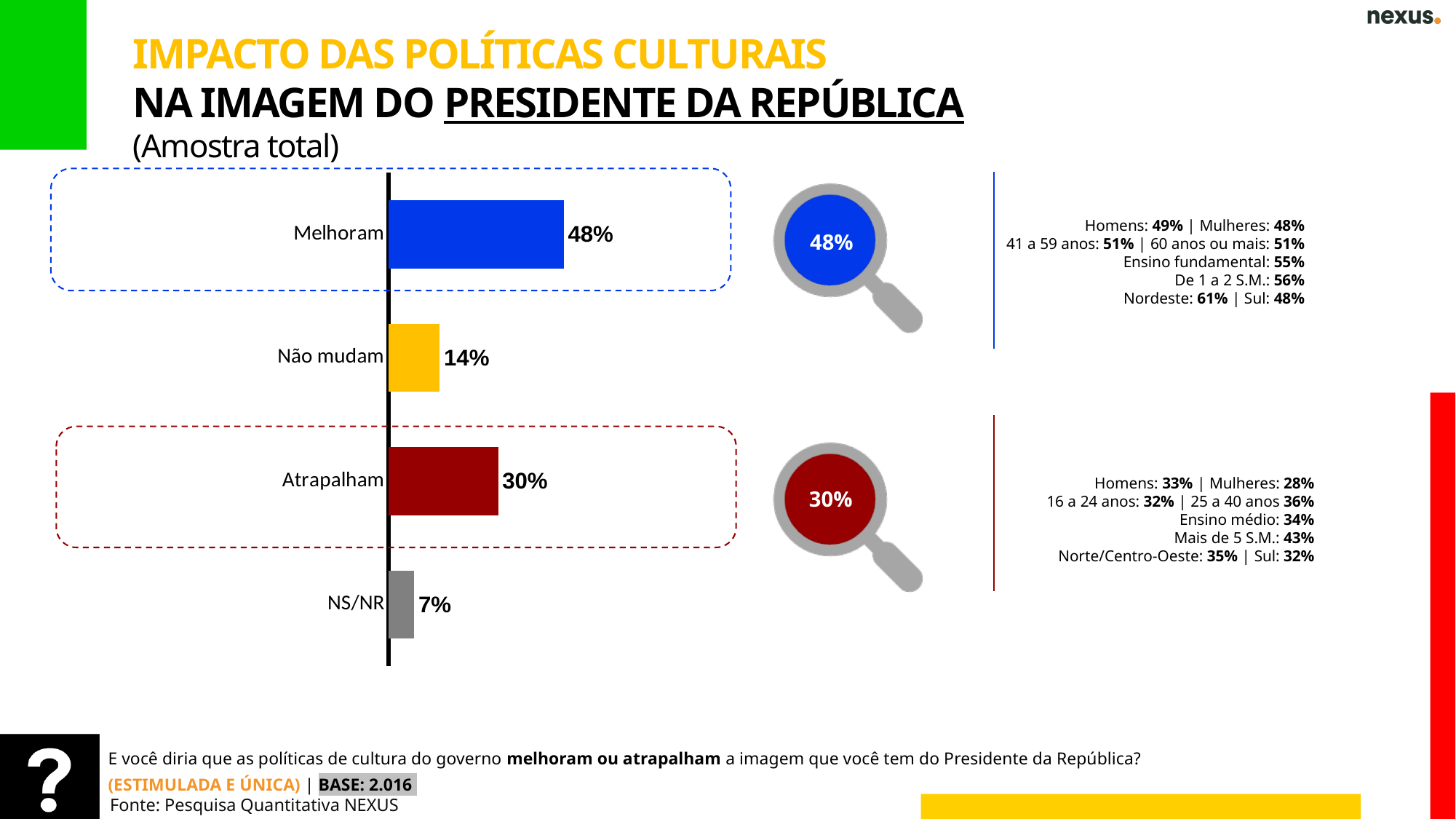
What is the value for Melhoram? 48% What is the difference between the values for Melhoram and Atrapalham? 18% What is the value for Não mudam? 14% Which category has the lowest value? NS/NR Which category has the highest value? Melhoram What colour is the bar for Atrapalham? Dark red What is the difference between the values for Não mudam and NS/NR? 7% What is the value for NS/NR? 7% What kind of chart is shown on the slide? Bar chart What is the value for Atrapalham? 30% How many categories are shown in the bar chart? 4 Which is larger, the value for Atrapalham or the value for Não mudam? Atrapalham